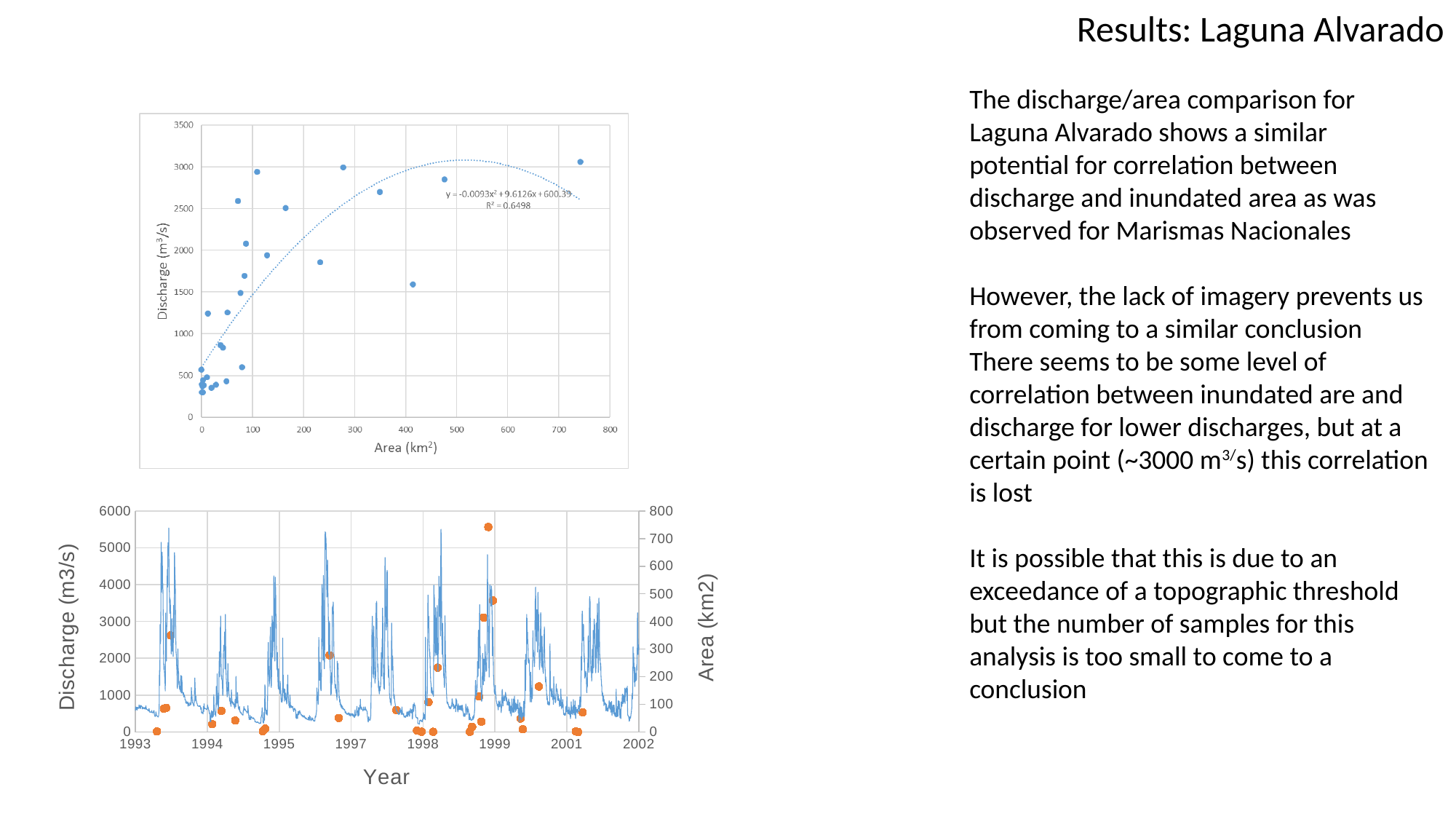
In the bottom chart, is the peak discharge in 1995 greater or less than 5000 m3/s? less In the top chart, is the discharge of the isolated point near 400 km² area greater or less than 2000? less In the top chart, what R² value is printed for the fitted trendline? 0.6498 In the bottom chart, what is the label of the right-hand y axis? Area (km2) In the top chart, what is the label of the x axis? Area (km²) In the bottom chart, is the peak discharge in 1993 greater or less than 5000 m3/s? greater What kind of chart is the top chart on the slide? scatter plot What kind of chart is the bottom chart on the slide (the blue discharge series)? line chart In the top chart, do discharge values generally rise or fall as area increases from 0 to about 300 km²? rise